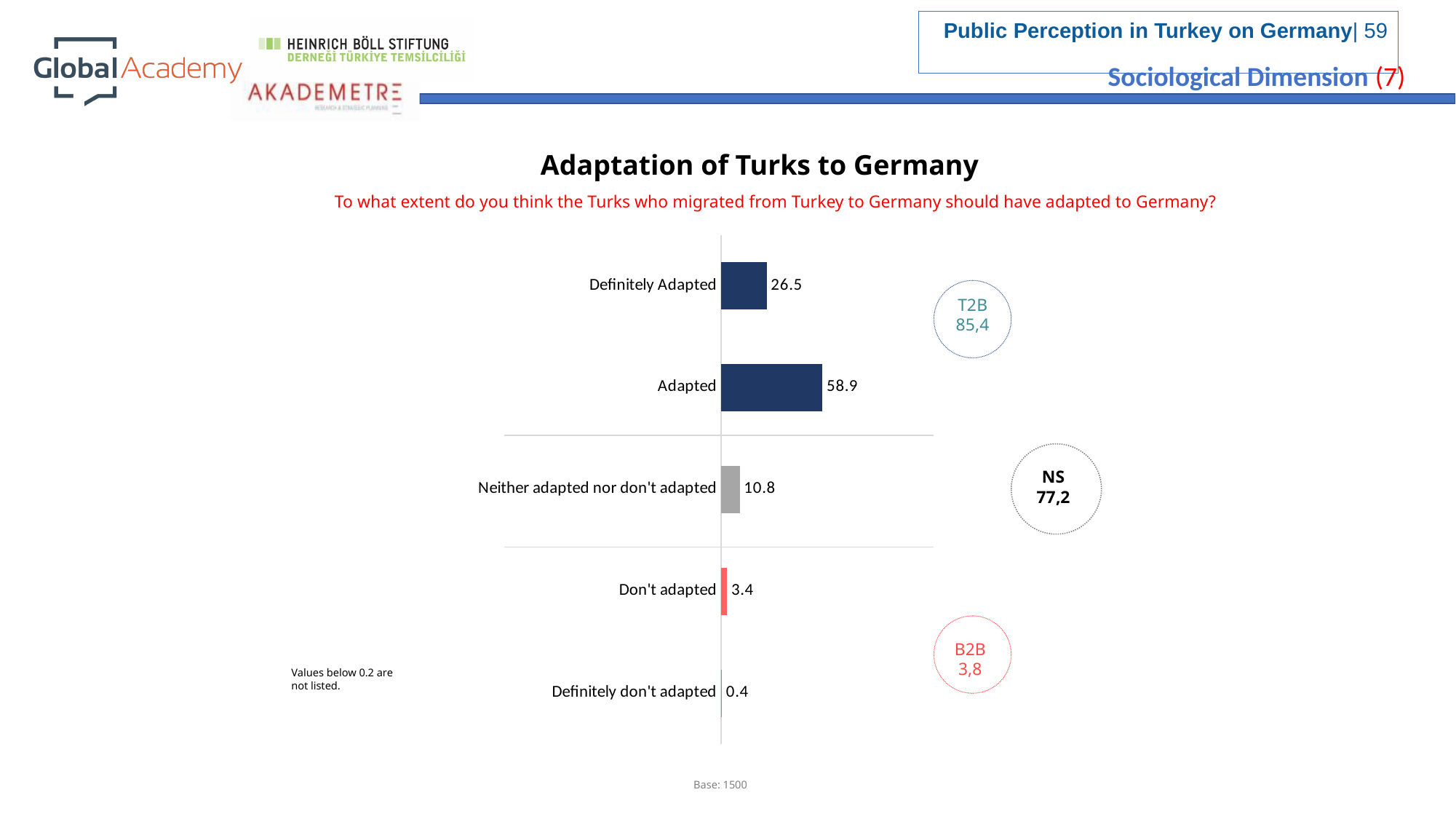
Which is larger, the value for "Neither adapted nor don't adapted" or the value for "Don't adapted"? Neither adapted nor don't adapted What kind of chart is shown on the slide? Bar chart What is the value for "Adapted"? 58.9 What is the value for "Definitely don't adapted"? 0.4 Which category has the highest value? Adapted What is the value for "Neither adapted nor don't adapted"? 10.8 Which category has the lowest value? Definitely don't adapted What is the value for "Definitely Adapted"? 26.5 What is the T2B value shown next to the chart? 85,4 What is the value for "Don't adapted"? 3.4 How many categories are shown in the chart? 5 What is the difference between the values for "Adapted" and "Definitely Adapted"? 32.4